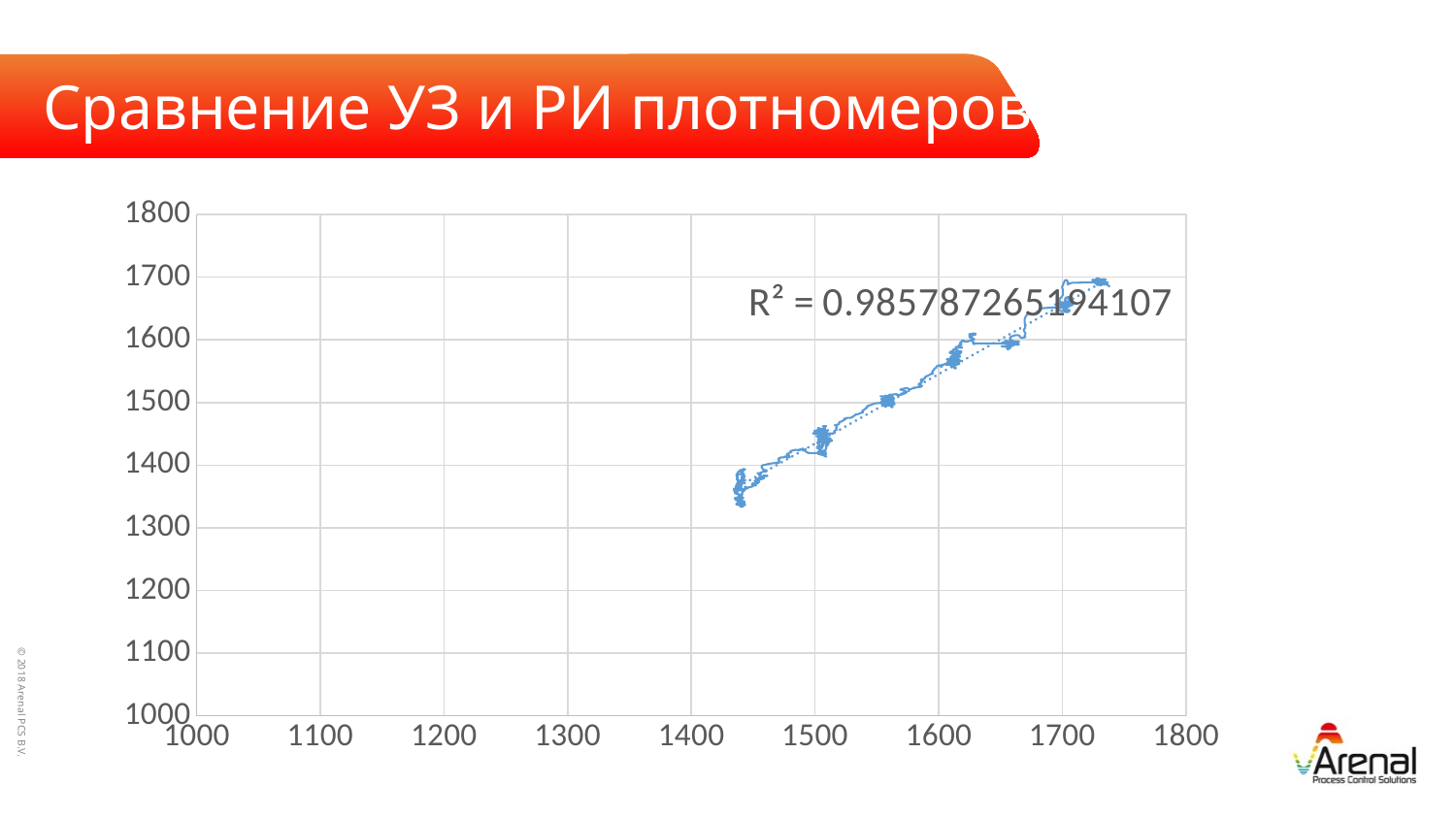
What kind of chart is shown on the slide? scatter chart Is the lowest plotted y value greater or less than 1400? less Is the largest x value of the plotted data greater or less than 1800? less What is the title of the slide containing the chart? Сравнение УЗ и РИ плотномеров What is the highest value shown on the x axis of the chart? 1800 What R² value is printed on the chart? R² = 0.985787265194107 Is the lowest plotted y value greater or less than 1300? greater Do the plotted values rise or fall as the x-axis value increases? rise What is the lowest value shown on the y axis of the chart? 1000